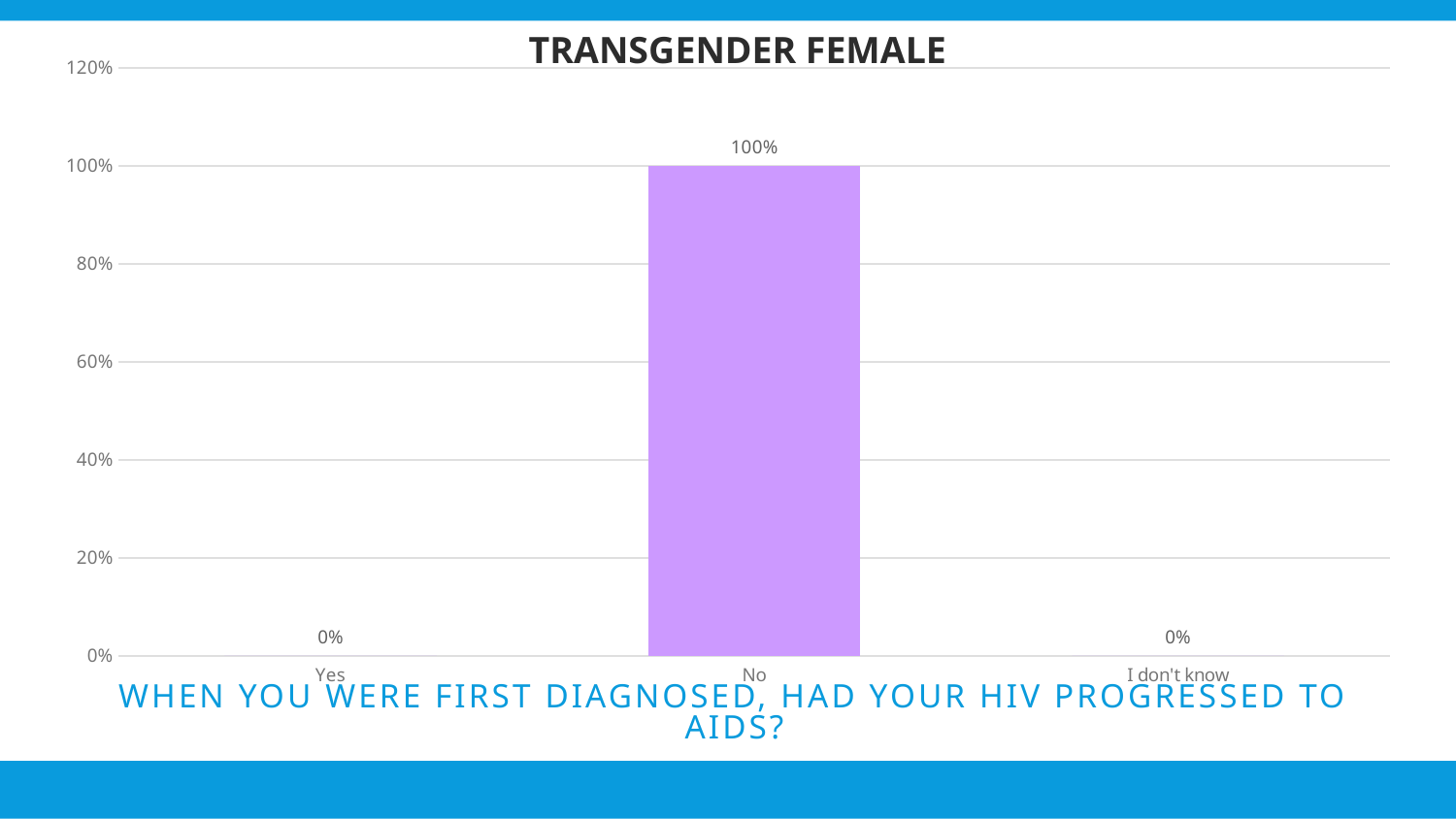
What is the value for the "I don't know" category? 0% Which is larger, the value for "No" or the value for "I don't know"? No What kind of chart is shown on the slide? bar chart What is the title of the chart? TRANSGENDER FEMALE What is the highest value shown on the y axis? 120% What is the value for the "No" category? 100% What is the value for the "Yes" category? 0% How many categories are shown on the x axis? 3 Which category has the highest value? No What is the difference between the values for "No" and "Yes"? 100% Is the value for "No" greater or less than 80%? greater